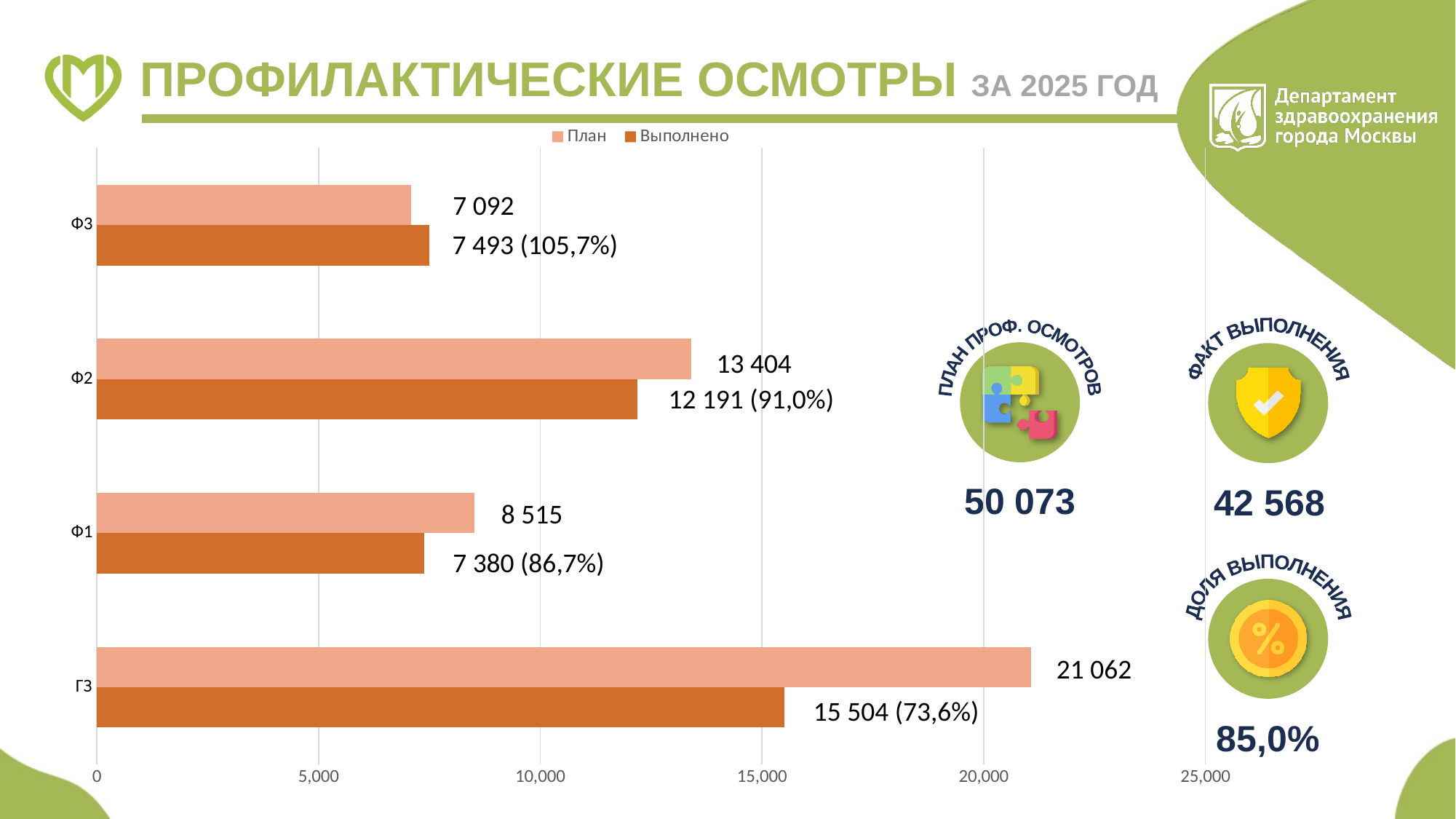
Is the План value for Ф1 greater or less than 10,000? less Which series is shown in the darker orange colour? Выполнено What is the План value for Ф2? 13 404 Which is larger for Ф3: the План value or the Выполнено value? Выполнено Which category has the lowest Выполнено value? Ф1 How many series does the legend list? 2 What percentage is shown next to the Выполнено bar for Ф3? 105,7% What is the Выполнено value for Г3? 15 504 Which category has the highest План value? Г3 What kind of chart is shown on the slide? bar chart How many categories are shown on the chart? 4 What is the difference between the План and Выполнено values for Г3? 5 558